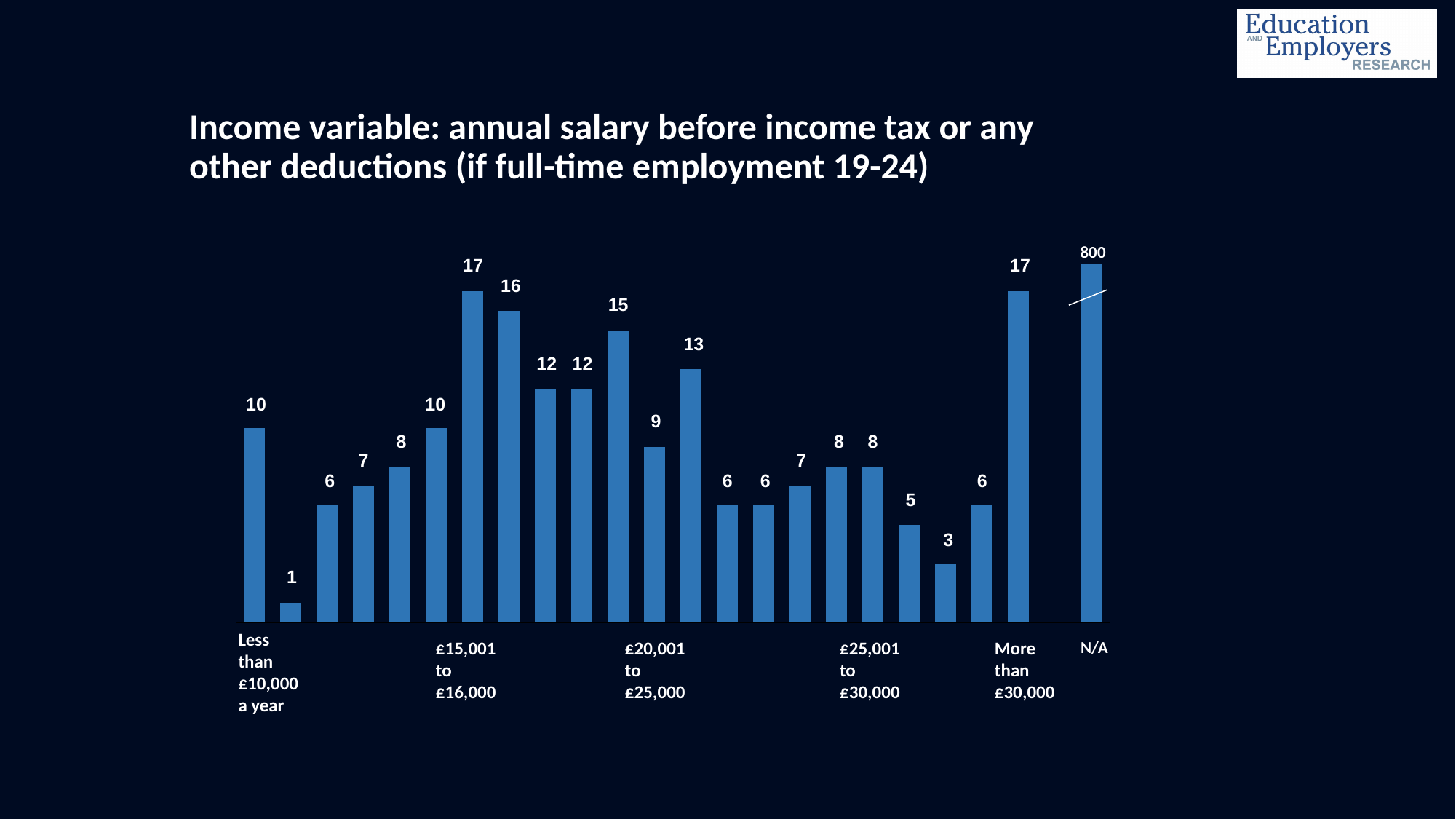
How many bars are plotted in the chart? 23 What is the title of the chart? Income variable: annual salary before income tax or any other deductions (if full-time employment 19-24) What is the value for the '£20,001 to £25,000' category? 9 What is the value for the 'Less than £10,000 a year' category? 10 Which category has the highest value? N/A What is the difference between the values for 'More than £30,000' and '£25,001 to £30,000'? 9 What is the value for the 'N/A' category? 800 What is the value for the 'More than £30,000' category? 17 What is the value for the '£25,001 to £30,000' category? 8 What is the value for the '£15,001 to £16,000' category? 10 Which is larger: the value for '£15,001 to £16,000' or the value for '£20,001 to £25,000'? £15,001 to £16,000 What kind of chart is shown on the slide? Bar chart